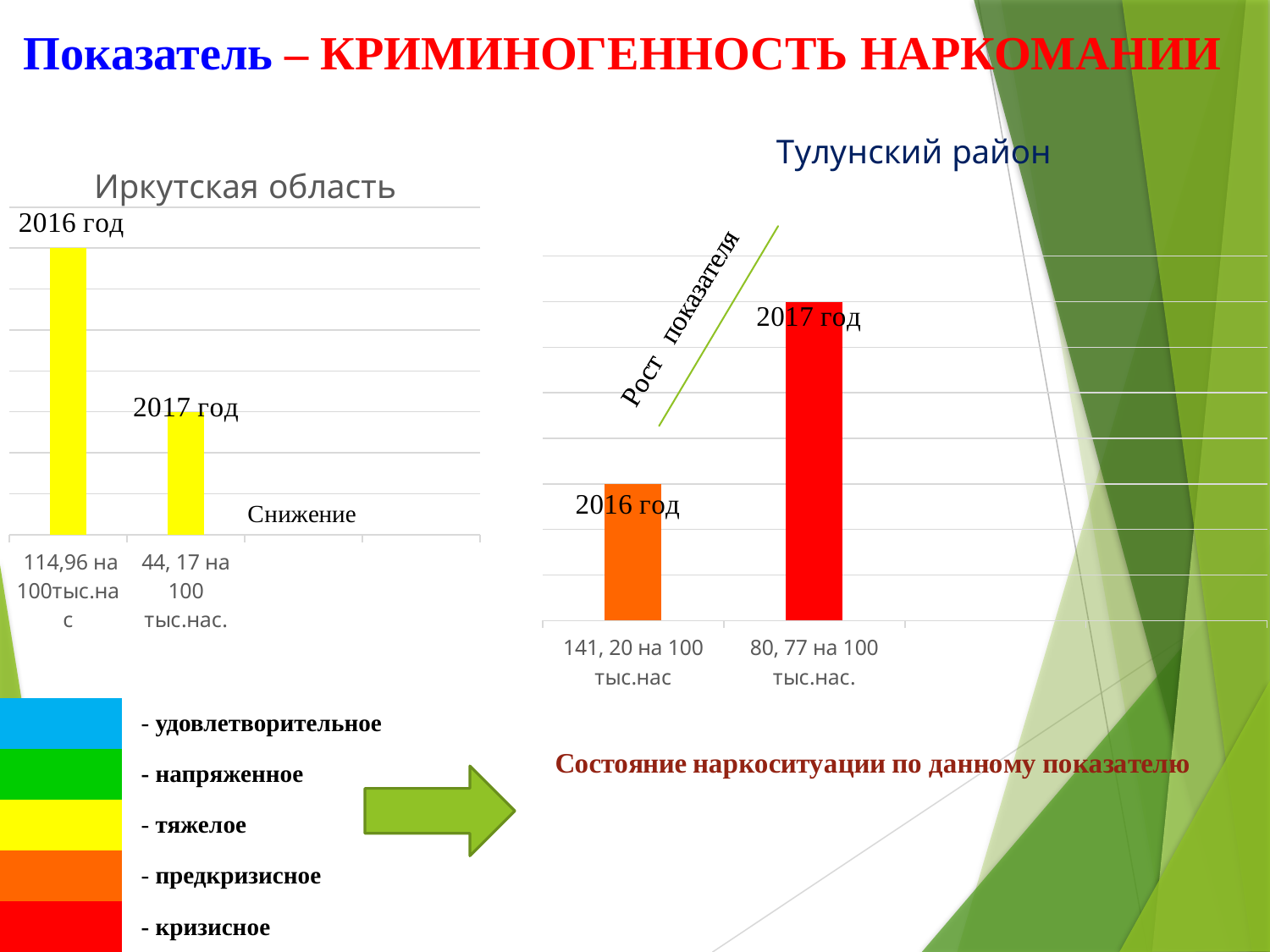
How many bars does the "Иркутская область" chart show? 2 In the "Иркутская область" chart, which year has the higher bar? 2016 год What kind of chart is the "Тулунский район" chart? bar chart In the "Иркутская область" chart, what value is printed for 2016 год? 114,96 на 100тыс.нас What colour are the bars in the "Иркутская область" chart? yellow In the "Тулунский район" chart, what colour is the 2017 год bar? red In the "Тулунский район" chart, what value is printed for 2017 год? 80, 77 на 100 тыс.нас. How many bars does the "Тулунский район" chart show? 2 What kind of chart is the "Иркутская область" chart? bar chart In the "Иркутская область" chart, what value is printed for 2017 год? 44, 17 на 100 тыс.нас. In the "Иркутская область" chart, do the values rise or fall from 2016 to 2017? fall In the "Тулунский район" chart, what value is printed for 2016 год? 141, 20 на 100 тыс.нас